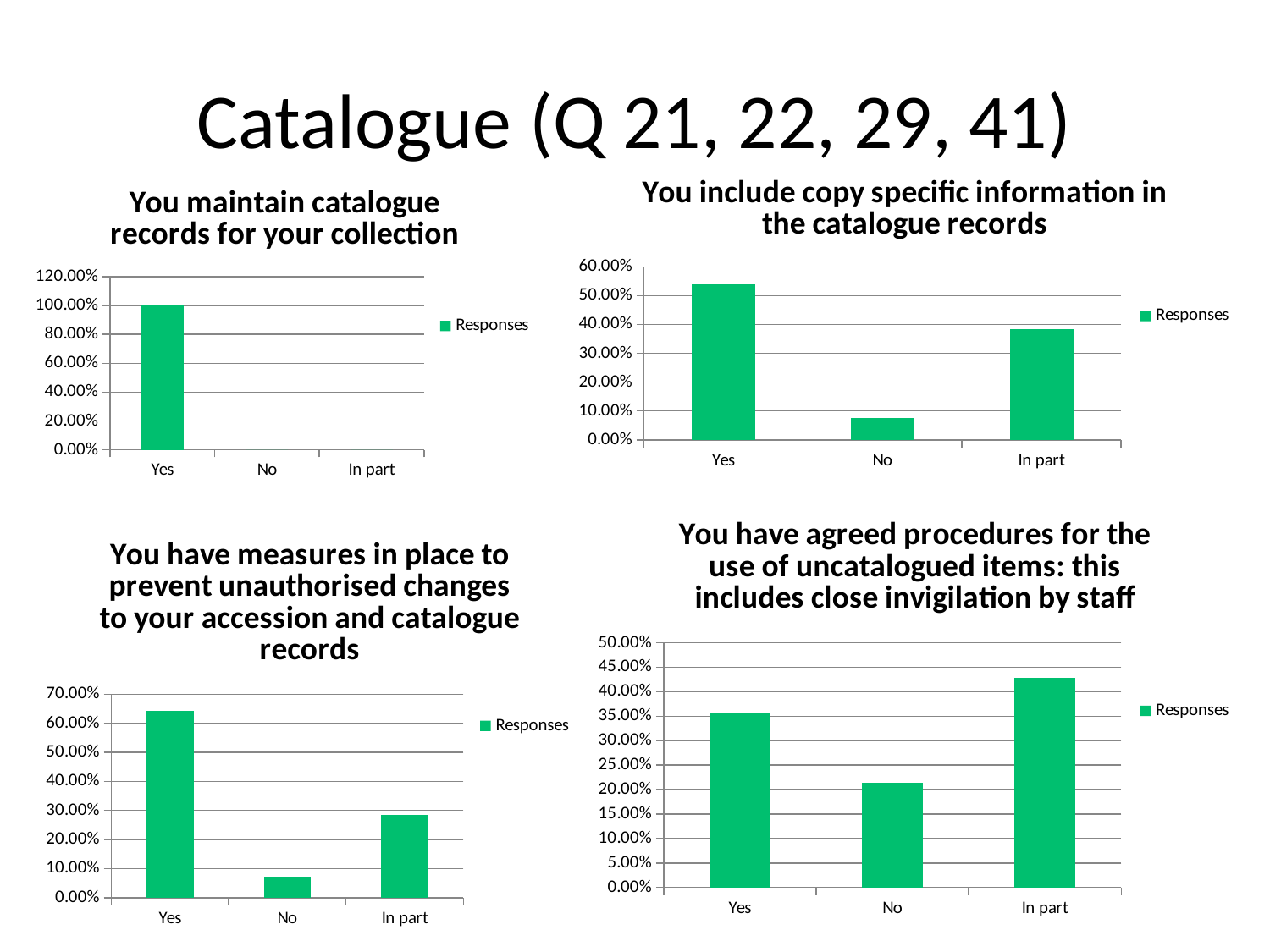
In the chart titled "You maintain catalogue records for your collection", what is the value for Yes? 100.00% In the chart titled "You have measures in place to prevent unauthorised changes to your accession and catalogue records", which category has the highest value? Yes What type of chart is the chart titled "You have measures in place to prevent unauthorised changes to your accession and catalogue records"? Bar chart In the chart titled "You include copy specific information in the catalogue records", which category has the lowest value? No In the chart titled "You have agreed procedures for the use of uncatalogued items: this includes close invigilation by staff", which is larger, the value for Yes or the value for No? Yes In the chart titled "You include copy specific information in the catalogue records", is the value for In part greater or less than 40.00%? less In the chart titled "You have agreed procedures for the use of uncatalogued items: this includes close invigilation by staff", is the value for In part greater or less than 40.00%? greater In the chart titled "You have measures in place to prevent unauthorised changes to your accession and catalogue records", is the value for No greater or less than 10.00%? less How many categories are shown on the x axis of the chart titled "You include copy specific information in the catalogue records"? 3 In the chart titled "You have agreed procedures for the use of uncatalogued items: this includes close invigilation by staff", which category has the highest value? In part In the chart titled "You maintain catalogue records for your collection", which category has the highest value? Yes